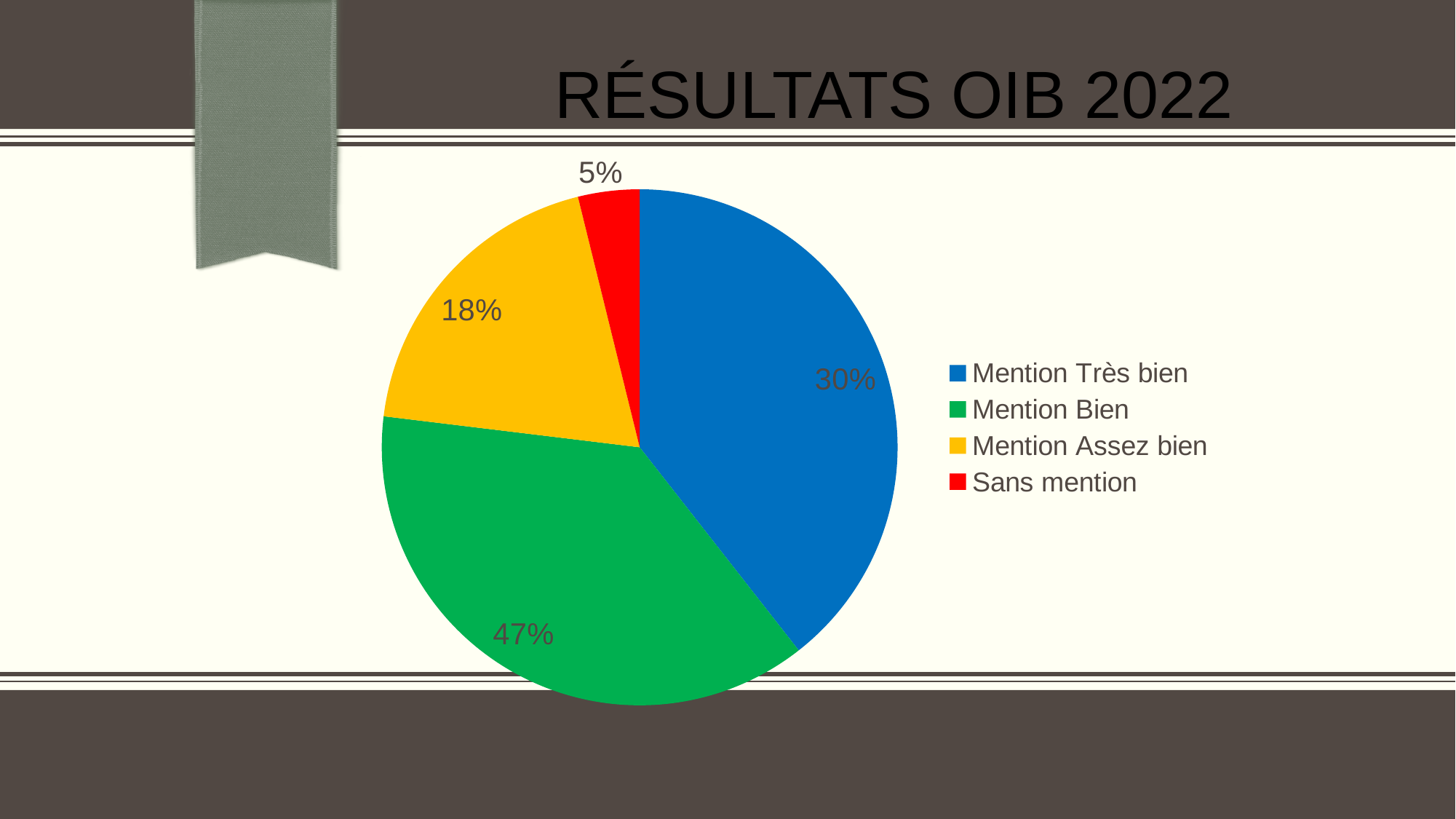
What is the difference in percentage points between Mention Bien and Mention Très bien? 17 What share of the pie does Mention Très bien have? 30% What share of the pie does Mention Assez bien have? 18% Which category has the smallest slice of the pie? Sans mention What share of the pie does Sans mention have? 5% What kind of chart is shown on the slide? pie chart Which is larger, the slice for Mention Assez bien or the slice for Sans mention? Mention Assez bien What colour is the slice for Mention Assez bien? yellow How many categories does the pie chart show? 4 What is the title of the slide containing the chart? RÉSULTATS OIB 2022